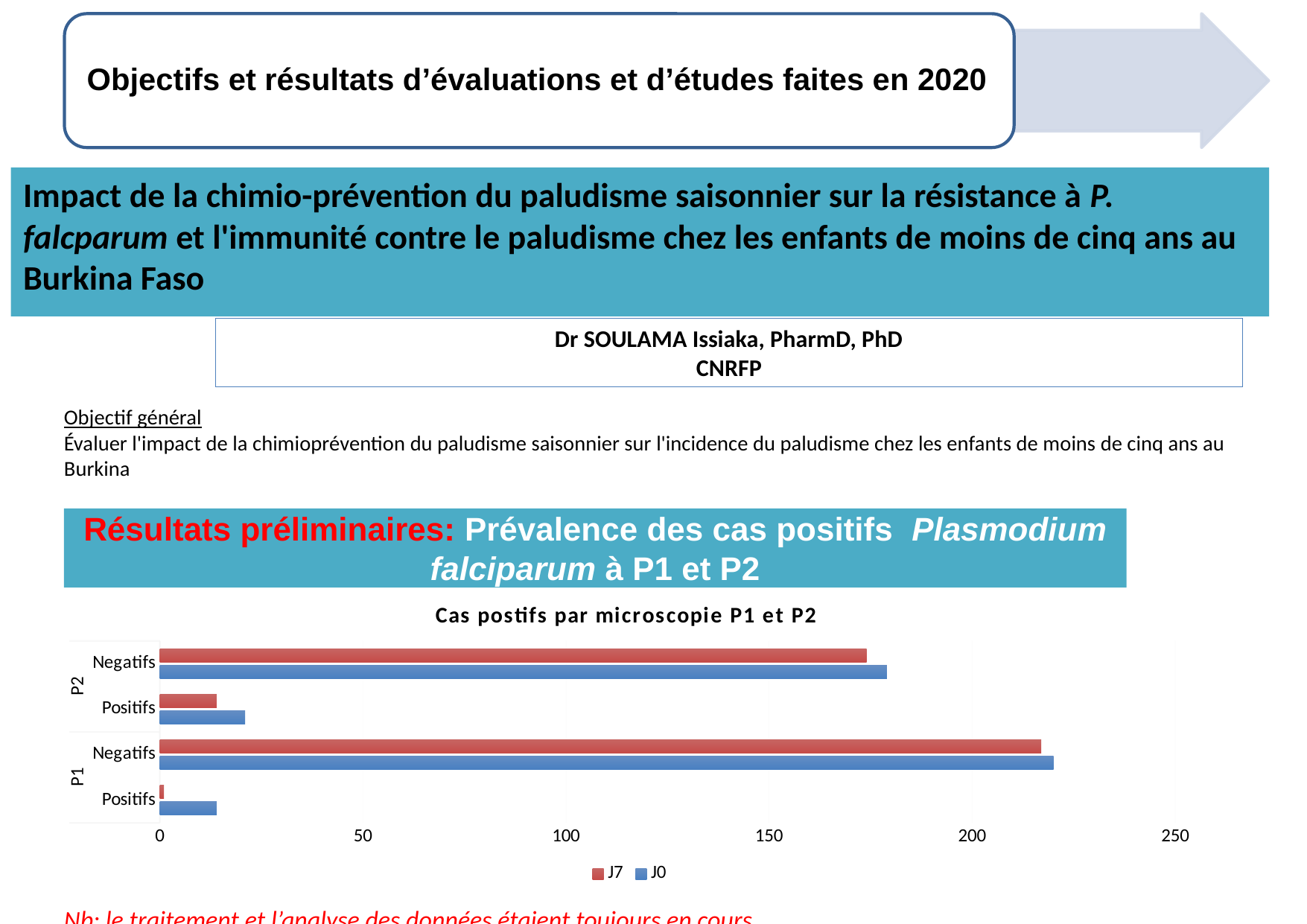
How many series does the chart legend list? 2 How many category bars groups (Positifs/Negatifs for P1 and P2) are plotted in the chart? 4 Within the J7 series, which category has the highest value? P1 Negatifs For P1 Positifs, which series has the larger value, J7 or J0? J0 Which series is shown in red in the chart? J7 What kind of chart is shown on the slide? bar chart Is the J0 value for P1 Negatifs greater or less than 200? greater Is the J7 value for P2 Negatifs greater or less than 200? less Is the J0 value for P2 Positifs greater or less than 50? less Within the J7 series, which category has the lowest value? P1 Positifs What is the title of the chart? Cas postifs par microscopie P1 et P2